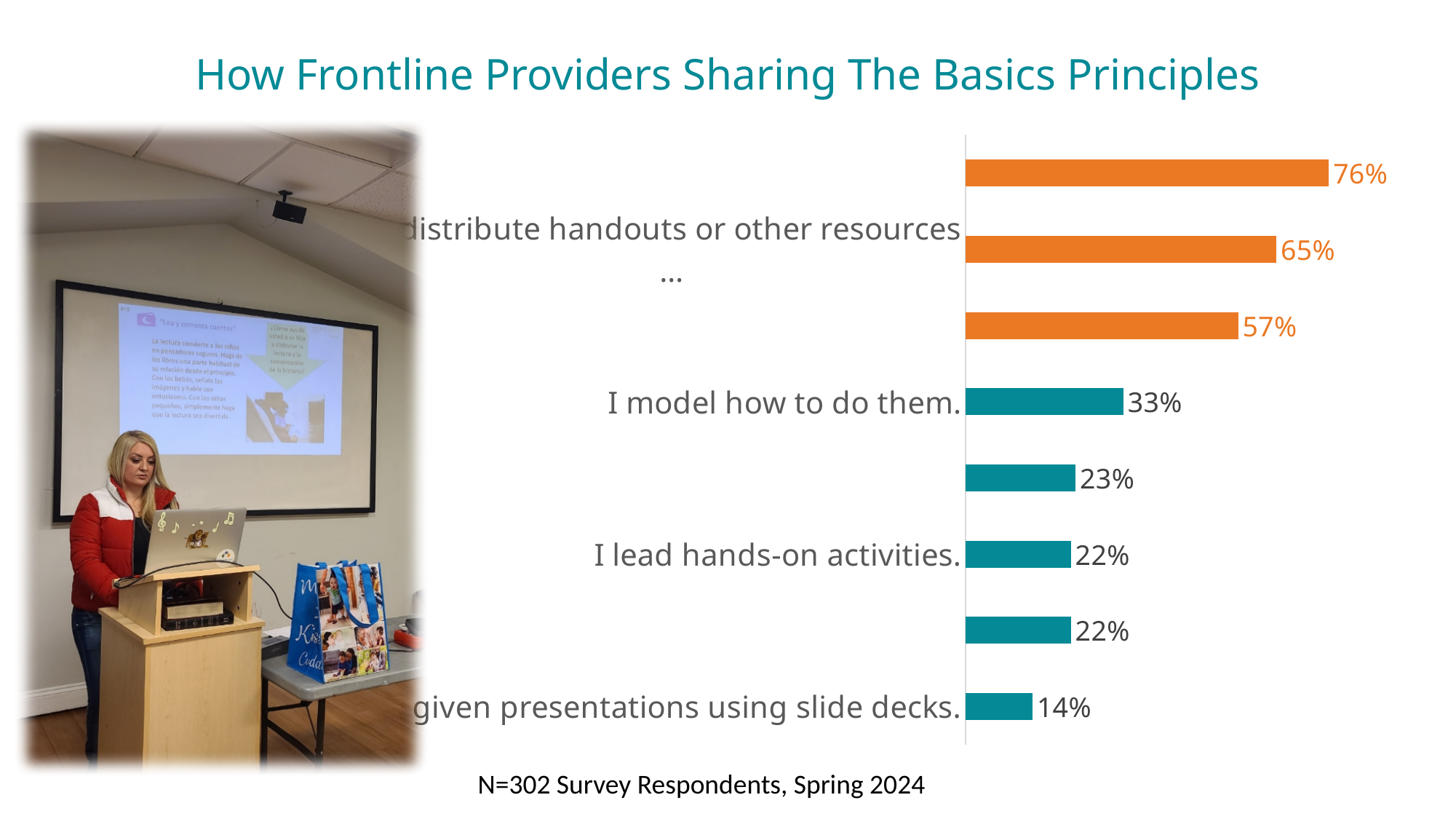
What is the highest value shown on the chart? 76% What percentage is shown for the bar labelled "distribute handouts or other resources ..."? 65% Which is larger: the value for "I model how to do them." or the value for "given presentations using slide decks."? I model how to do them. Which labelled category has the lowest value on the chart? given presentations using slide decks. What is the difference between the highest value (76%) and the lowest value (14%) on the chart? 62 percentage points How many bars on the chart are coloured orange? 3 What percentage is shown for "I model how to do them."? 33% What percentage is shown for "I lead hands-on activities."? 22% What is the difference between the values for "I model how to do them." and "I lead hands-on activities."? 11 percentage points How many bars are plotted on the chart? 8 What kind of chart is shown on the slide? Bar chart What percentage is shown for the bar labelled "given presentations using slide decks."? 14%